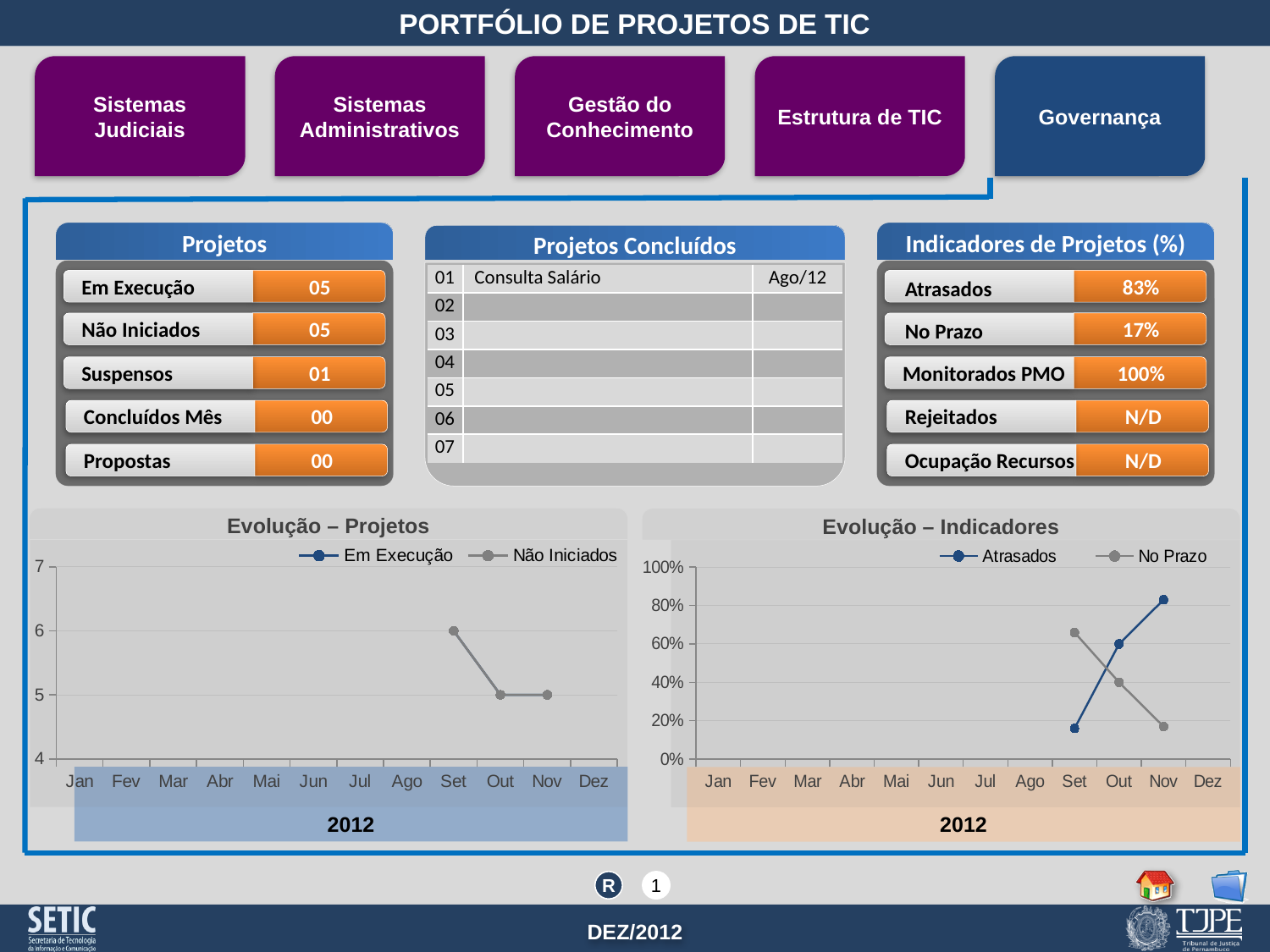
In the "Evolução – Projetos" chart, does the Não Iniciados line rise or fall from Set to Nov? fall In the "Evolução – Indicadores" chart, which series has the higher value in Nov, Atrasados or No Prazo? Atrasados In the "Evolução – Indicadores" chart, does the Atrasados line rise or fall from Set to Nov? rise In the "Evolução – Projetos" chart, what is the value for Não Iniciados in Nov? 5 In the "Evolução – Indicadores" chart, is the value for No Prazo in Set greater or less than 60%? greater In the "Evolução – Indicadores" chart, is the value for No Prazo in Nov greater or less than 20%? less How many month categories are shown on the x axis of the "Evolução – Projetos" chart? 12 How many series does the legend of the "Evolução – Indicadores" chart list? 2 How many series does the legend of the "Evolução – Projetos" chart list? 2 In the "Evolução – Projetos" chart, what is the value for Não Iniciados in Set? 6 What kind of chart is the "Evolução – Projetos" chart? line chart In the "Evolução – Indicadores" chart, is the value for Atrasados in Nov greater or less than 80%? greater